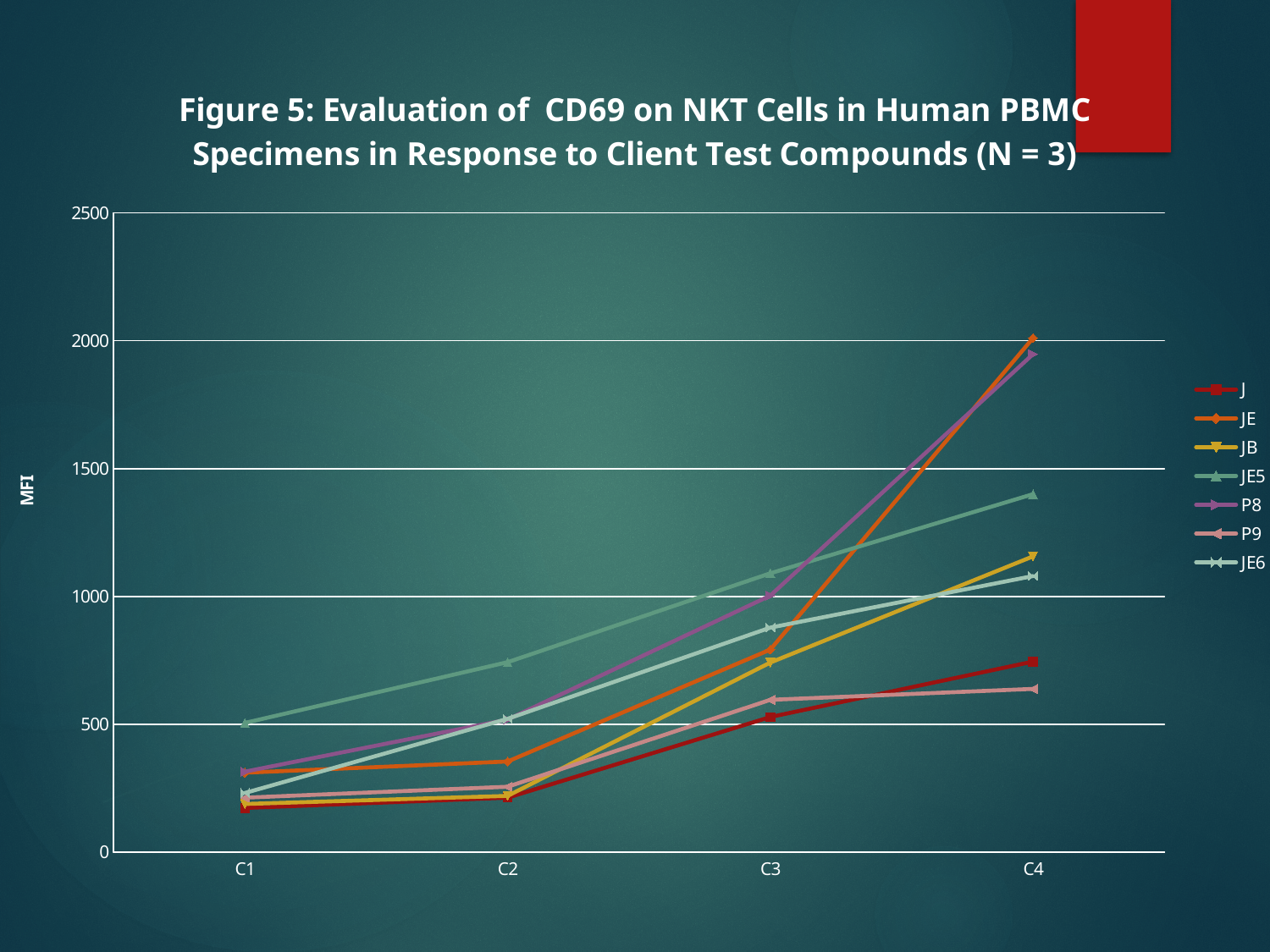
Is the value for P9 at C4 greater or less than 1000? less How many categories are shown on the x axis? 4 Which series has the highest value at C2? JE5 How many series does the legend list? 7 Is the value for JE5 at C2 greater or less than 500? greater At C4, which is larger, the value for JE5 or the value for JB? JE5 Is the value for J at C4 greater or less than 1000? less Does the value for JE rise or fall from C1 to C4? rise What kind of chart is shown on the slide? line chart Which series has the lowest value at C4? P9 Which series has the highest value at C1? JE5